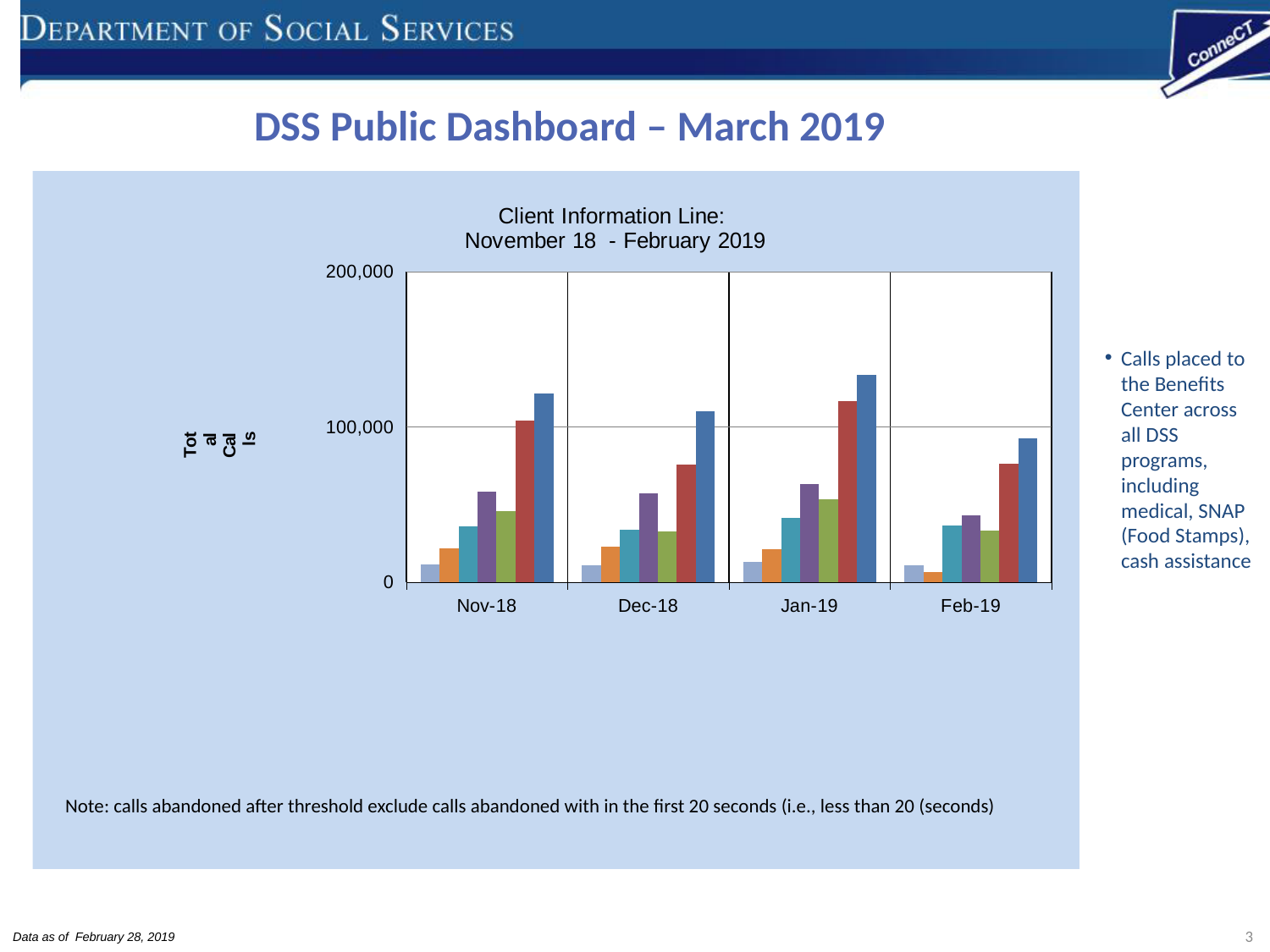
Is the value of the tallest (dark blue) bar for Jan-19 greater or less than 100,000? greater How many bars are plotted for each month in the chart? 7 Is the value of the red bar for Dec-18 greater or less than 100,000? less Is the value of the tallest (dark blue) bar for Feb-19 greater or less than 100,000? less What is the label on the vertical axis of the chart? Total Calls Which month has the larger dark blue bar, Jan-19 or Feb-19? Jan-19 How many months are shown on the x axis of the chart? 4 What is the title of the chart? Client Information Line: November 18 - February 2019 What kind of chart is shown on the slide? bar chart Which month contains the tallest bar in the chart? Jan-19